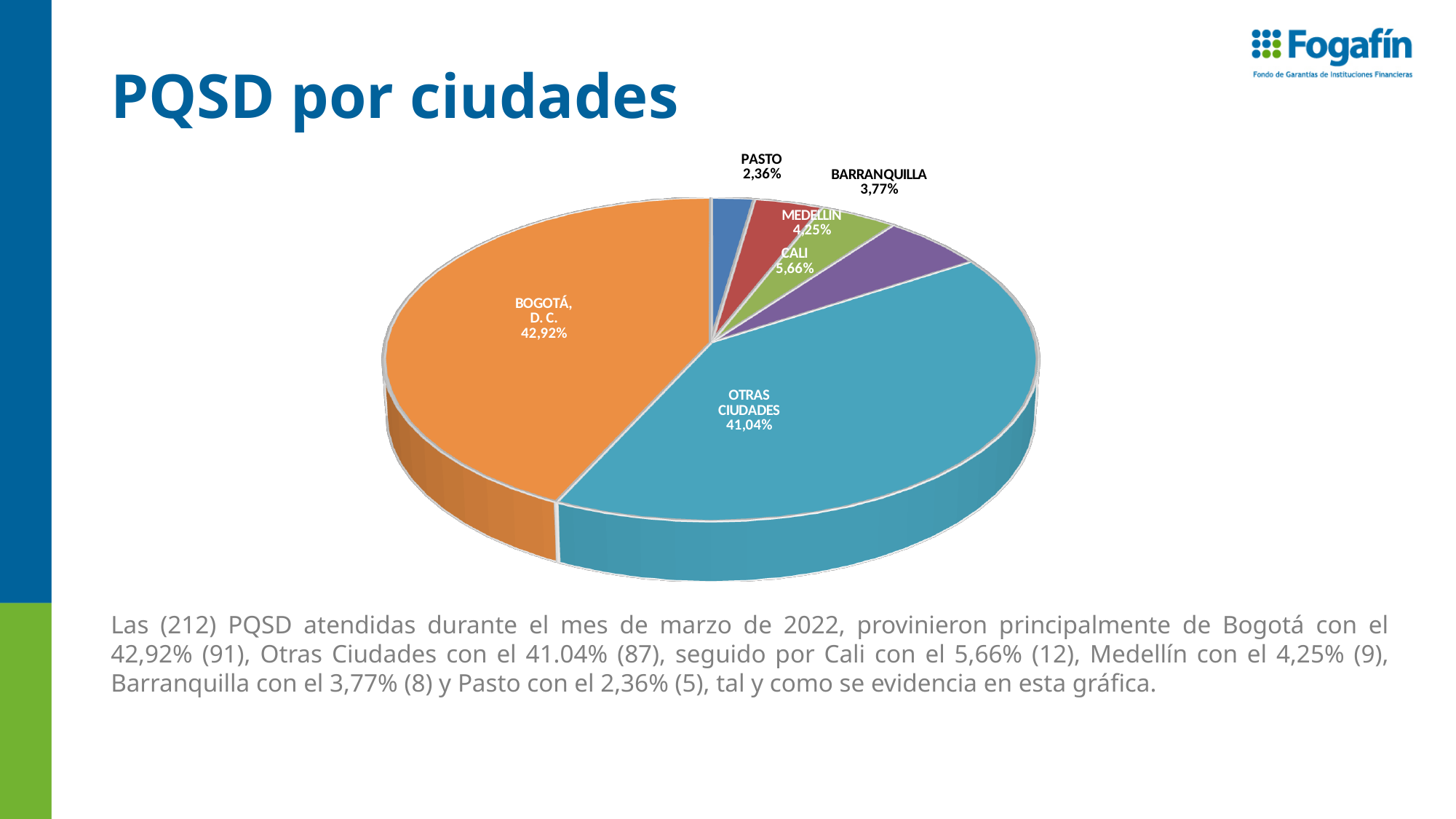
What percentage is shown for Otras Ciudades? 41,04% What is the difference in percentage points between Bogotá, D. C. and Otras Ciudades? 1,88 What kind of chart is shown on the slide? Pie chart What percentage is shown for Barranquilla? 3,77% What percentage is shown for Pasto? 2,36% What percentage is shown for Cali? 5,66% Which is larger, the share for Cali or the share for Medellín? Cali How many slices does the pie chart have? 6 What share of PQSD does Bogotá, D. C. account for? 42,92% What percentage is shown for Medellín? 4,25% Which city has the smallest share of the pie? Pasto Which city has the largest share of the pie? Bogotá, D. C.